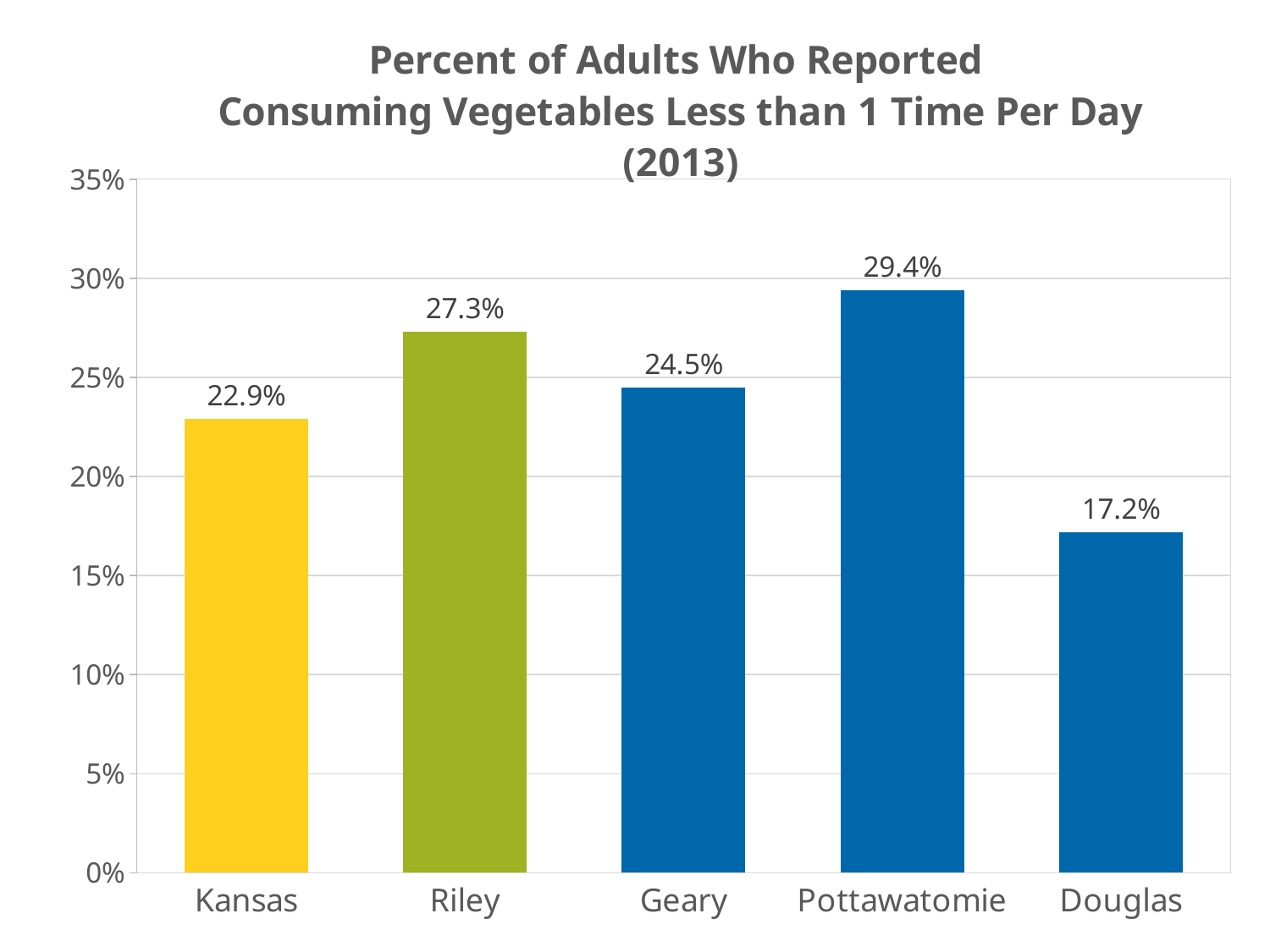
Is the value for Douglas greater or less than 20%? less How many categories are shown on the chart? 5 Which category has the lowest value? Douglas What is the value for Geary? 24.5% What is the value for Douglas? 17.2% What is the value for Kansas? 22.9% Which category has the highest value? Pottawatomie What is the difference between the values for Pottawatomie and Douglas? 12.2% What is the value for Riley? 27.3% What kind of chart is shown on the slide? Bar chart Which is larger, the value for Geary or the value for Kansas? Geary What is the difference between the values for Riley and Kansas? 4.4%